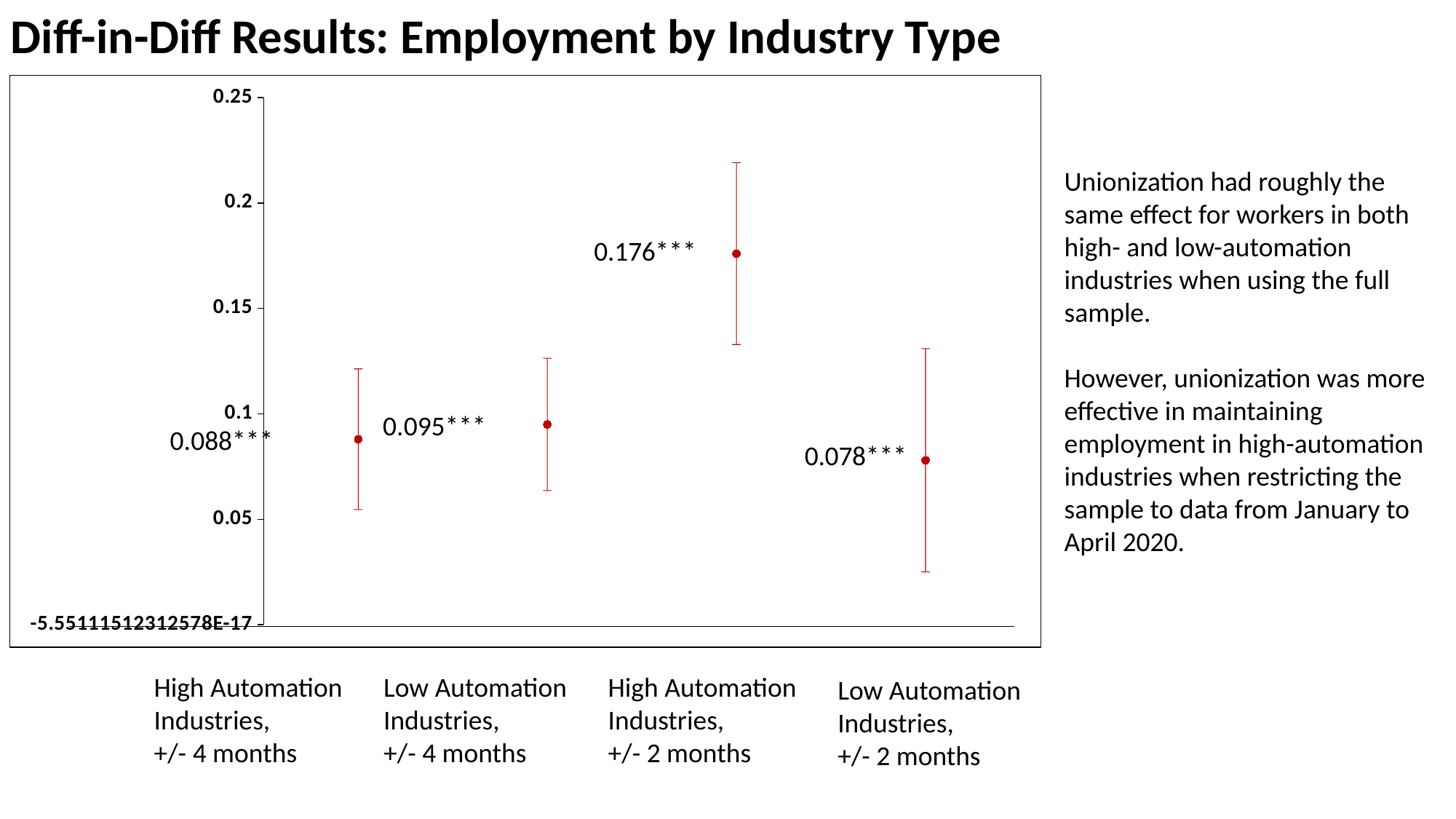
What is the plotted value for High Automation Industries, +/- 2 months? 0.176*** What is the title of the slide's chart? Diff-in-Diff Results: Employment by Industry Type What is the difference between the values for High Automation Industries, +/- 2 months and Low Automation Industries, +/- 2 months? 0.098 What is the plotted value for Low Automation Industries, +/- 4 months? 0.095*** Is the value for High Automation Industries, +/- 2 months greater or less than 0.15? greater What is the plotted value for High Automation Industries, +/- 4 months? 0.088*** What kind of chart is shown on the slide? Scatter (point) chart with error bars How many categories are plotted on the chart? 4 Which category has the lowest plotted value? Low Automation Industries, +/- 2 months Which category has the highest plotted value? High Automation Industries, +/- 2 months What is the plotted value for Low Automation Industries, +/- 2 months? 0.078*** Which is larger: the value for High Automation Industries, +/- 4 months or Low Automation Industries, +/- 4 months? Low Automation Industries, +/- 4 months